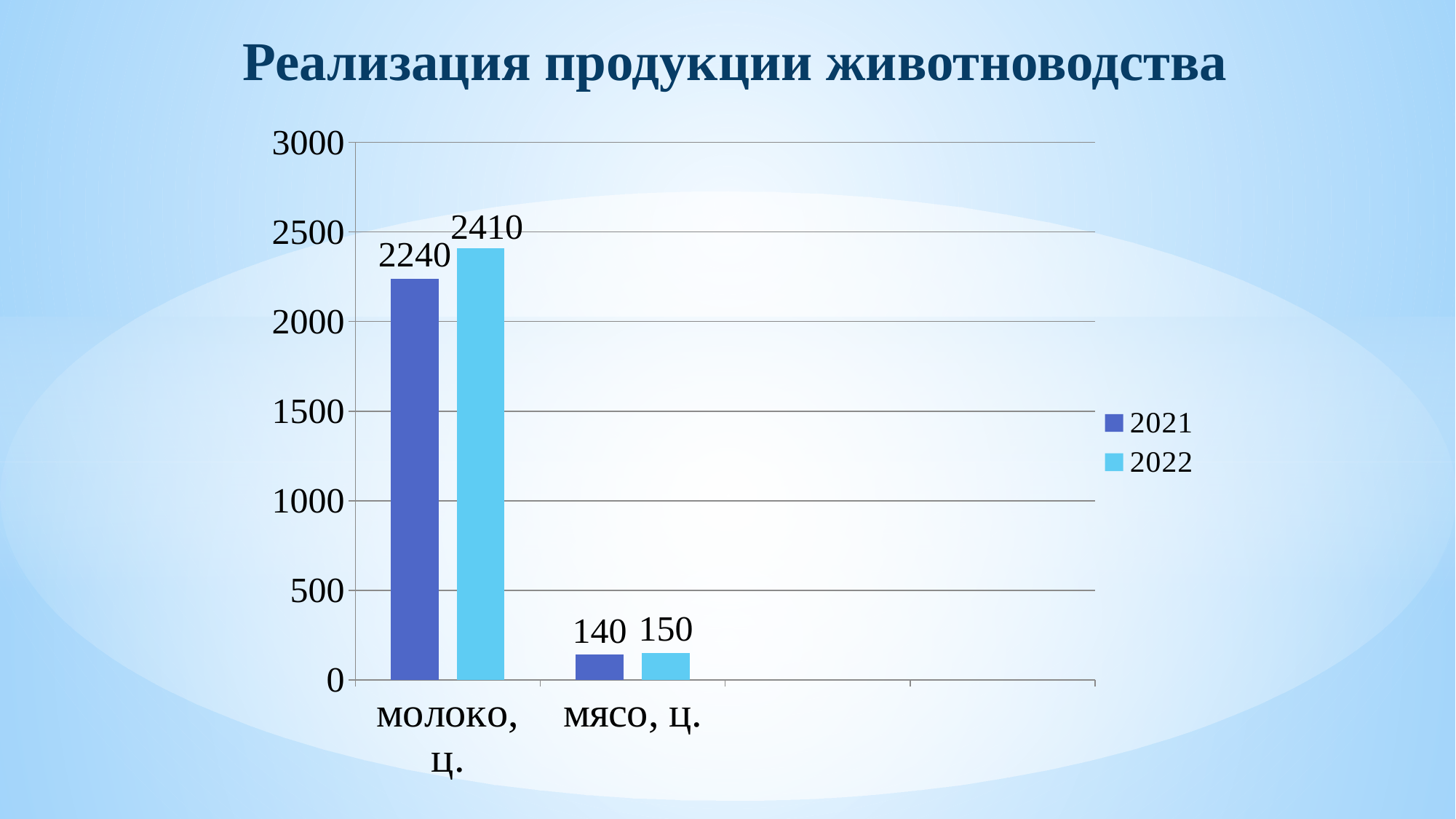
What is the difference between the 2022 and 2021 values for молоко, ц.? 170 How many series does the legend list? 2 Which category has the highest value in the 2022 series? молоко, ц. What kind of chart is shown on the slide? bar chart What is the difference between the 2022 and 2021 values for мясо, ц.? 10 What is the value for мясо, ц. in 2022? 150 Which is larger for молоко, ц.: the 2021 value or the 2022 value? 2022 Which category has the lowest value in the 2021 series? мясо, ц. What is the value for молоко, ц. in 2021? 2240 How many categories are shown on the x axis? 2 What is the value for мясо, ц. in 2021? 140 What is the value for молоко, ц. in 2022? 2410